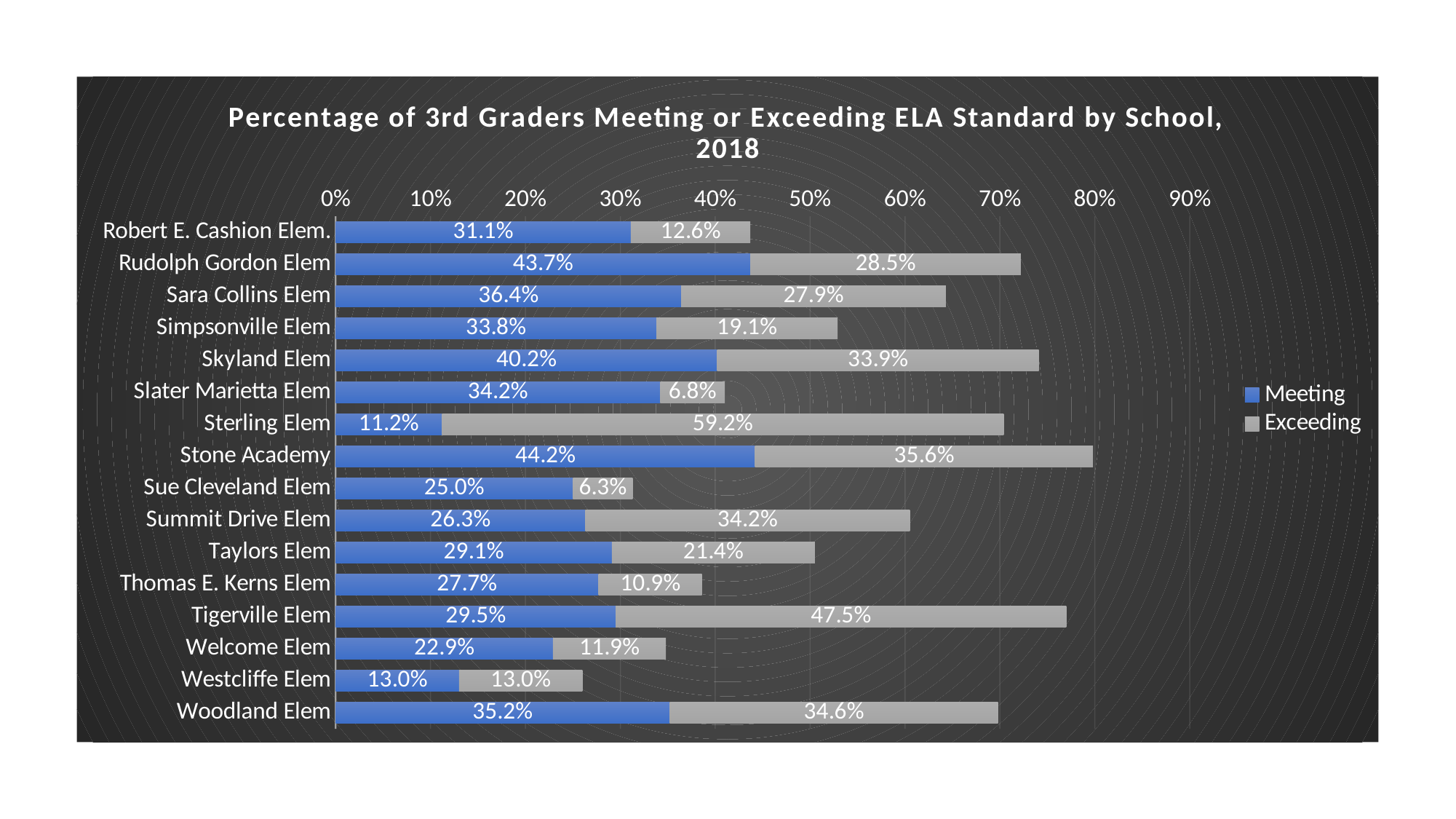
Which school has the lowest Exceeding percentage? Sue Cleveland Elem What type of chart is shown on the slide? Stacked bar chart What is the Exceeding value for Tigerville Elem? 47.5% What percentage of 3rd graders at Stone Academy are in the Meeting category? 44.2% How many series does the legend list? 2 How many schools are shown in the chart? 16 Which is larger for Summit Drive Elem, the Meeting value or the Exceeding value? Exceeding Which school has the lowest Meeting percentage? Sterling Elem What is the difference between the Meeting and Exceeding values for Rudolph Gordon Elem? 15.2% What is the Meeting value for Westcliffe Elem? 13.0% Which school has the highest Exceeding percentage? Sterling Elem What is the combined Meeting and Exceeding total for Stone Academy? 79.8%